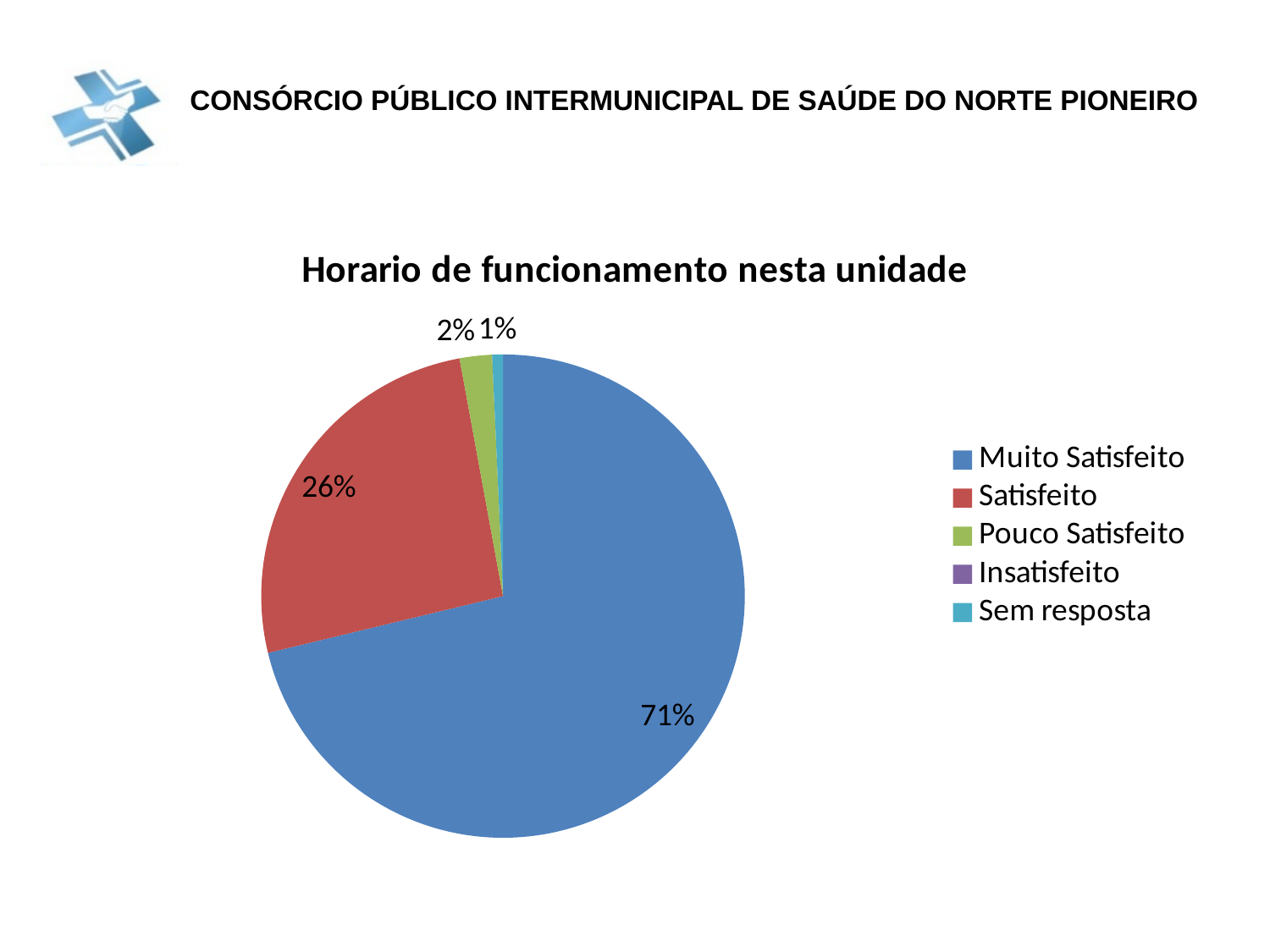
What colour is the Muito Satisfeito slice? Blue What kind of chart is shown on the slide? Pie chart What is the title of the chart? Horario de funcionamento nesta unidade What percentage of the pie is labelled for Muito Satisfeito? 71% What percentage is shown for the Satisfeito slice? 26% What percentage is shown for Sem resposta? 1% Which category has the largest slice of the pie? Muito Satisfeito How many categories does the legend list? 5 What is the combined share of Muito Satisfeito and Satisfeito? 97% What is the difference in percentage points between Muito Satisfeito and Satisfeito? 45 percentage points What percentage is shown for Pouco Satisfeito? 2% Which slice is larger, Satisfeito or Pouco Satisfeito? Satisfeito